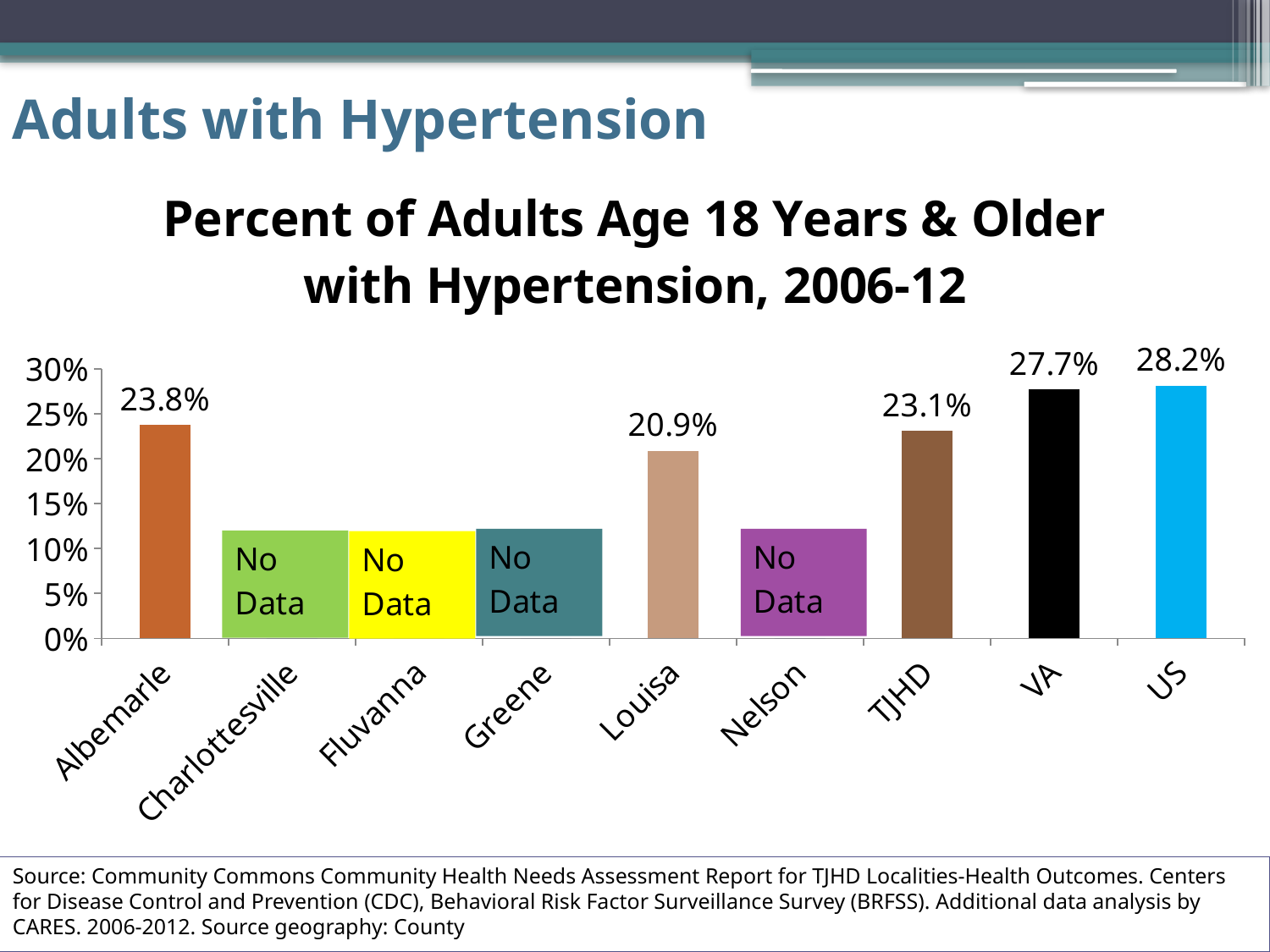
Which is larger, the value for Albemarle or the value for TJHD? Albemarle What is the value for VA? 27.7% How many categories are shown on the x axis? 9 What is the value for Albemarle? 23.8% What is the difference between the values for US and VA? 0.5% Among the categories with a printed value, which has the lowest value? Louisa Which category has the highest value? US What is the value for TJHD? 23.1% What is the value for Louisa? 20.9% What is the value for US? 28.2% Is the value for Louisa greater or less than 25%? less What kind of chart is this? bar chart